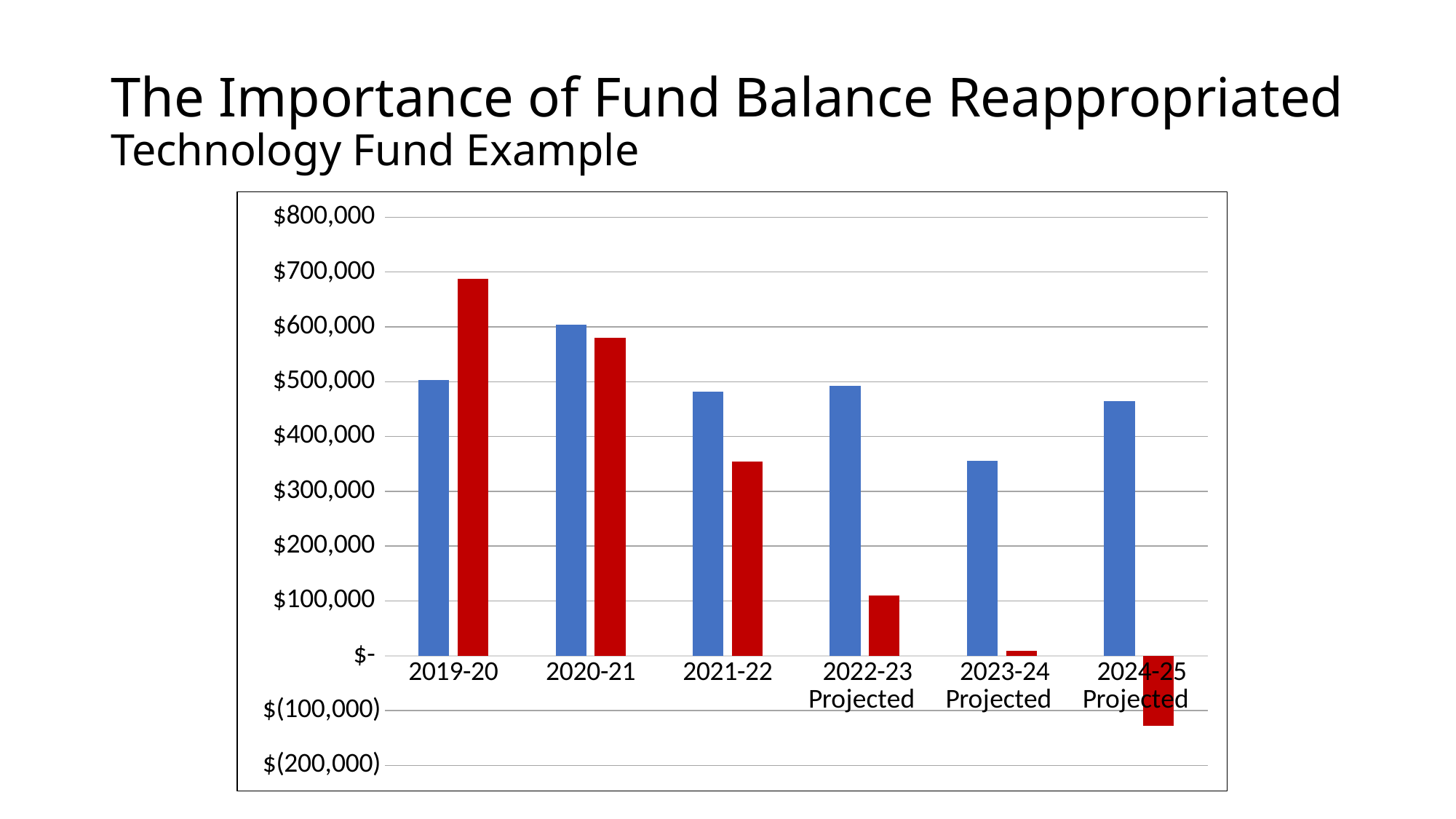
Is the blue bar for 2023-24 Projected greater or less than $400,000? less What kind of chart is shown on the slide? bar chart Which category has the lowest red bar? 2024-25 Projected Do the red bars generally rise or fall from 2019-20 to 2024-25 Projected? fall Which category has the highest blue bar? 2020-21 For 2021-22, which bar is larger, the blue bar or the red bar? blue Which category has the highest red bar? 2019-20 Is the red bar for 2022-23 Projected greater or less than $200,000? less Is the red bar for 2019-20 greater or less than $600,000? greater What is the subtitle of the slide below the main title? Technology Fund Example Which category has the lowest blue bar? 2023-24 Projected How many categories are shown along the x axis of the chart? 6